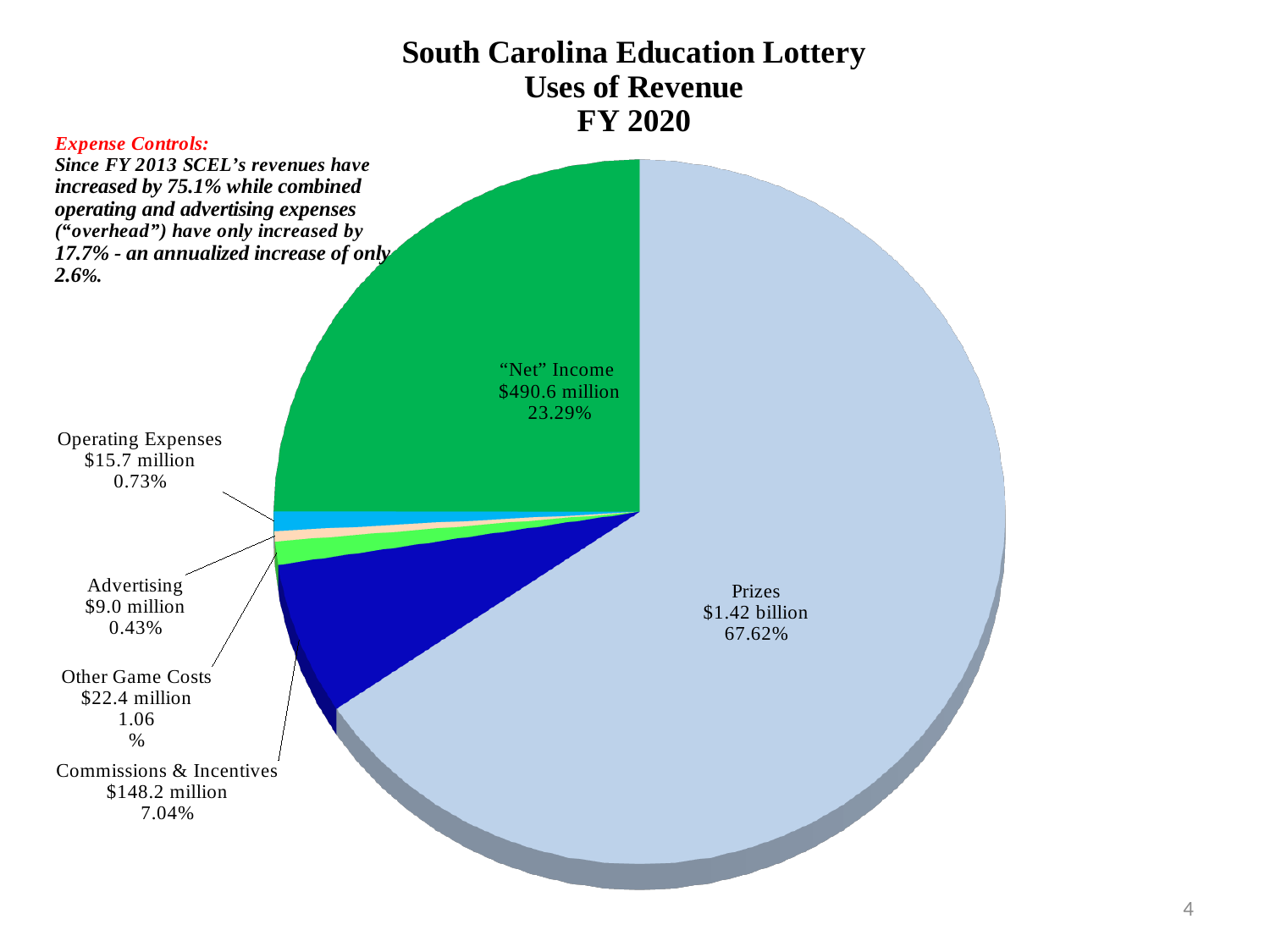
What kind of chart is shown on the slide? Pie chart What share of the pie does Prizes represent? 67.62% What is the title of the chart? South Carolina Education Lottery Uses of Revenue FY 2020 What is the dollar value shown for Other Game Costs? $22.4 million What percentage is shown for Commissions & Incentives? 7.04% Which category has the largest slice of the pie? Prizes What is the dollar value shown for "Net" Income? $490.6 million Which category has the smallest slice of the pie? Advertising Which is larger, Operating Expenses or Advertising? Operating Expenses How many slices does the pie chart have? 6 What is the difference in percentage points between Prizes and "Net" Income? 44.33 What is the dollar value shown for Prizes? $1.42 billion